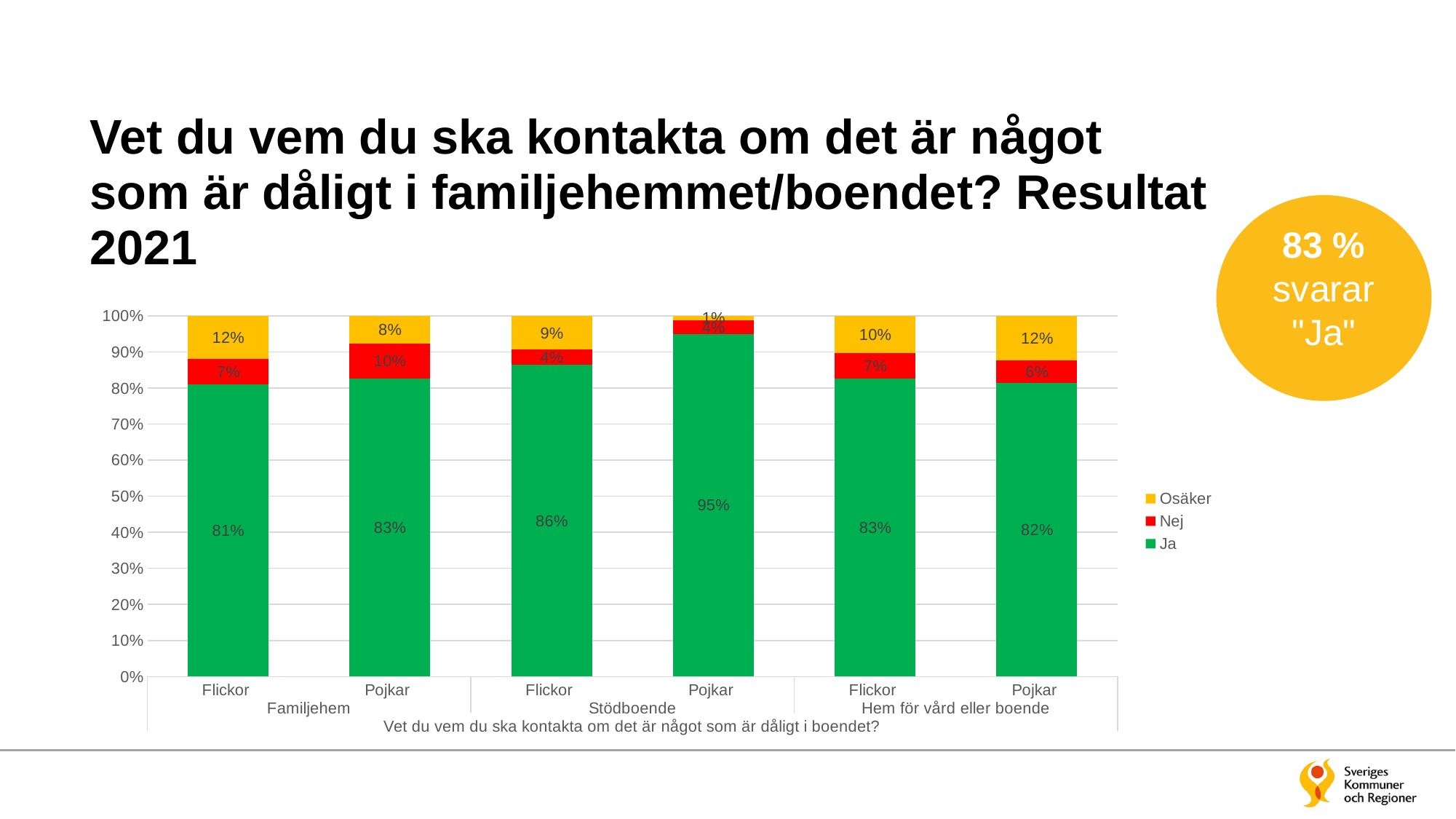
What is the "Nej" value for Pojkar in Familjehem? 10% What is the "Osäker" share for Pojkar in Stödboende? 1% What kind of chart is shown on the slide? Stacked bar chart Which colour represents "Ja" in the chart? Green What percentage of Flickor in Familjehem answered "Ja"? 81% How many bars are shown in the chart? 6 How many series does the legend list? 3 Which group has the highest "Ja" share? Pojkar in Stödboende What is the "Osäker" value for Pojkar in Hem för vård eller boende? 12% Which is larger: the "Nej" share for Pojkar in Familjehem or for Flickor in Familjehem? Pojkar in Familjehem What is the difference between the "Ja" share for Pojkar in Stödboende and Flickor in Stödboende? 9 percentage points Which group has the lowest "Ja" share? Flickor in Familjehem